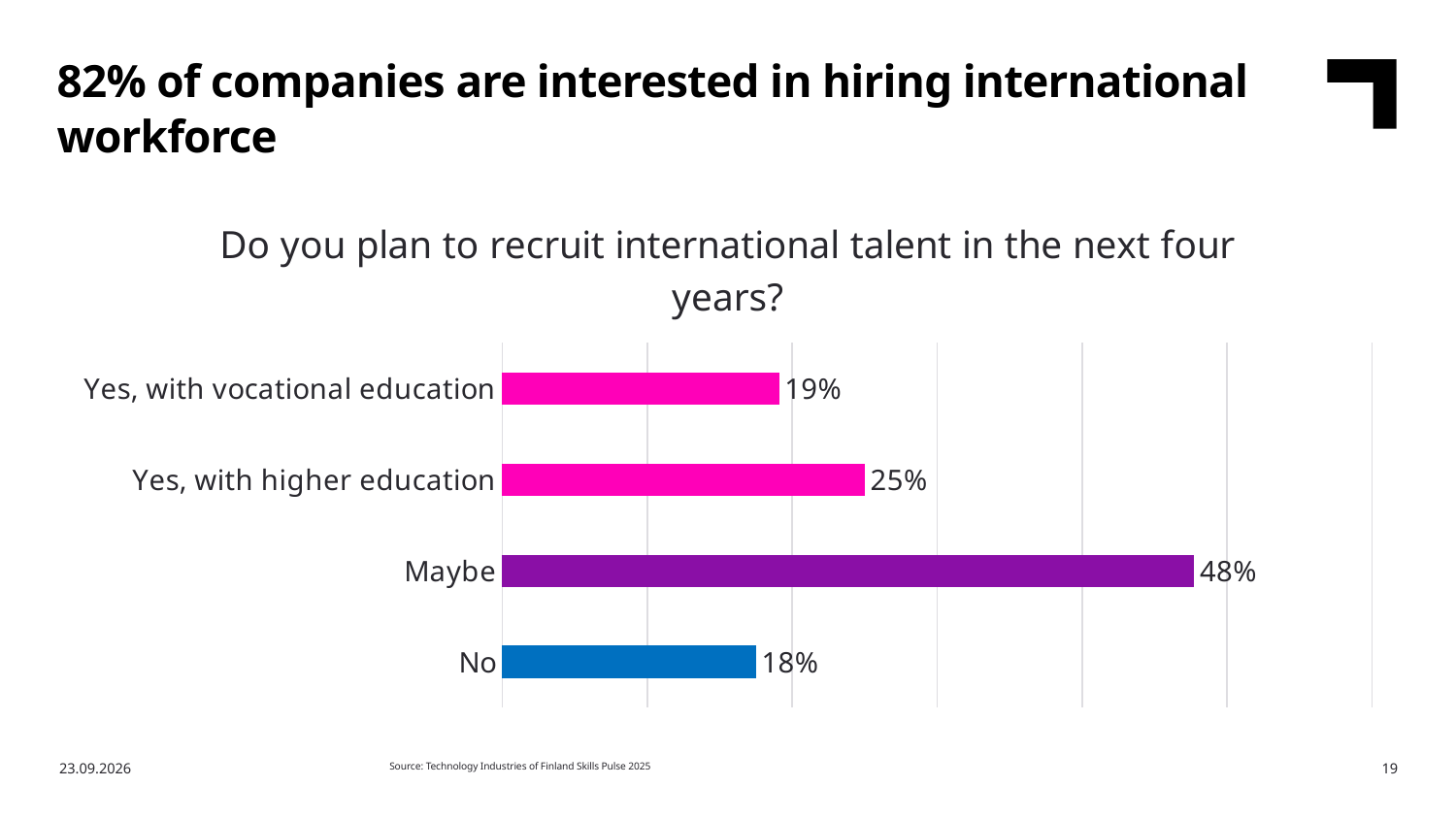
How many response categories are shown in the chart? 4 What is the value for "Yes, with higher education"? 25% What percentage of companies answered "No"? 18% Which response category has the lowest value? No What percentage of companies answered "Maybe" to the question about recruiting international talent? 48% What is the value for "Yes, with vocational education"? 19% Which response category has the highest value? Maybe Which is larger: the value for "Yes, with higher education" or the value for "Yes, with vocational education"? Yes, with higher education What is the difference between the "Maybe" value and the "Yes, with higher education" value? 23% What is the title of the chart? Do you plan to recruit international talent in the next four years? What colour is the bar for "Maybe"? Purple What kind of chart is shown on the slide? Bar chart